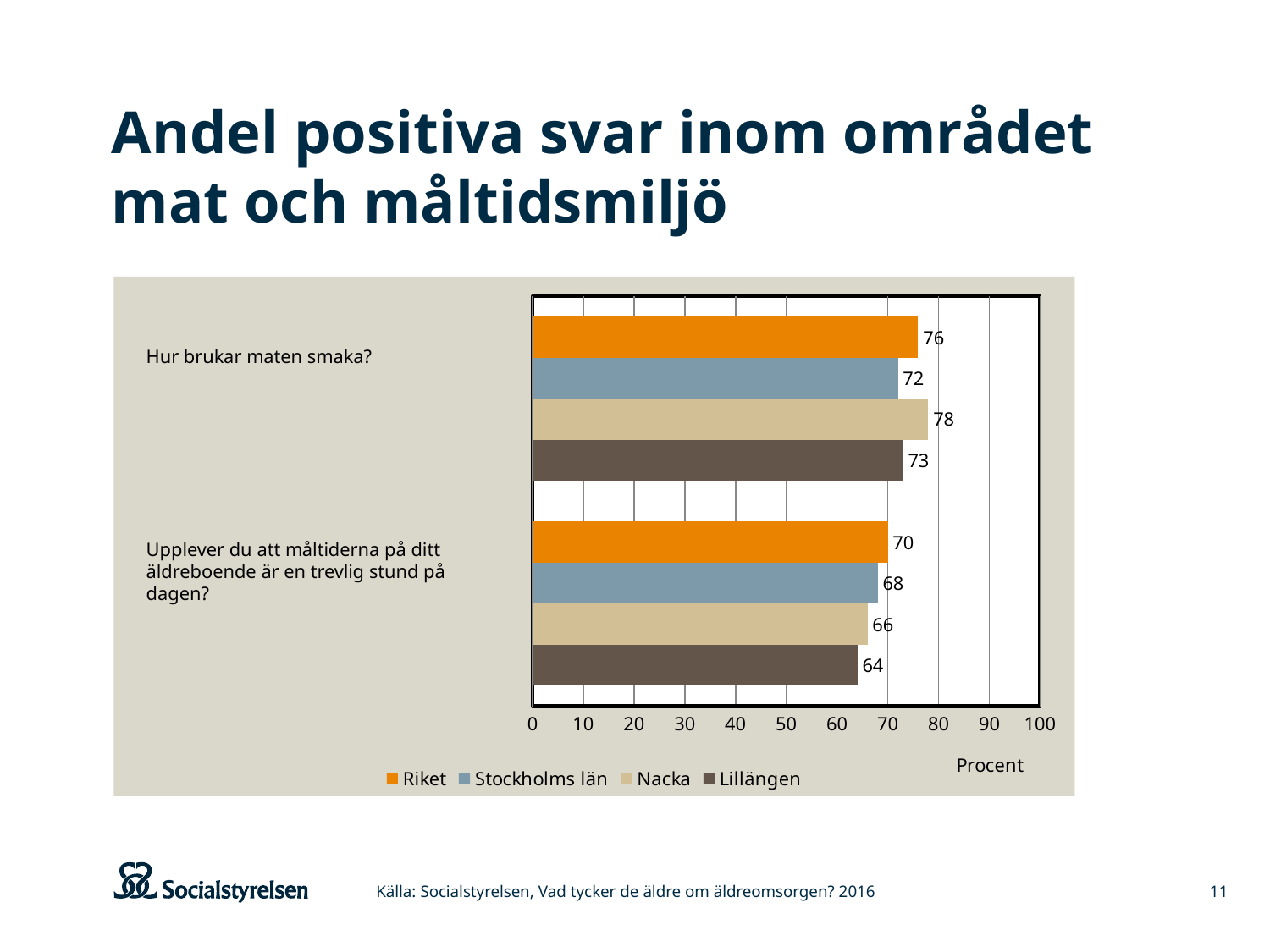
Which series has the lowest value for the question "Upplever du att måltiderna på ditt äldreboende är en trevlig stund på dagen?"? Lillängen How many series does the legend list? 4 What is the value for Stockholms län for the question "Upplever du att måltiderna på ditt äldreboende är en trevlig stund på dagen?"? 68 Which series has the highest value for the question "Hur brukar maten smaka?"? Nacka What is the value for Lillängen for the question "Upplever du att måltiderna på ditt äldreboende är en trevlig stund på dagen?"? 64 What is the value for Nacka for the question "Hur brukar maten smaka?"? 78 What is the value for Riket for the question "Hur brukar maten smaka?"? 76 What is the label of the x axis? Procent What kind of chart is shown on the slide? Bar chart Which is larger for "Upplever du att måltiderna på ditt äldreboende är en trevlig stund på dagen?": Riket or Nacka? Riket What is the difference between the Nacka and Stockholms län values for "Hur brukar maten smaka?"? 6 Is the value for Lillängen for "Hur brukar maten smaka?" greater or less than 70? greater